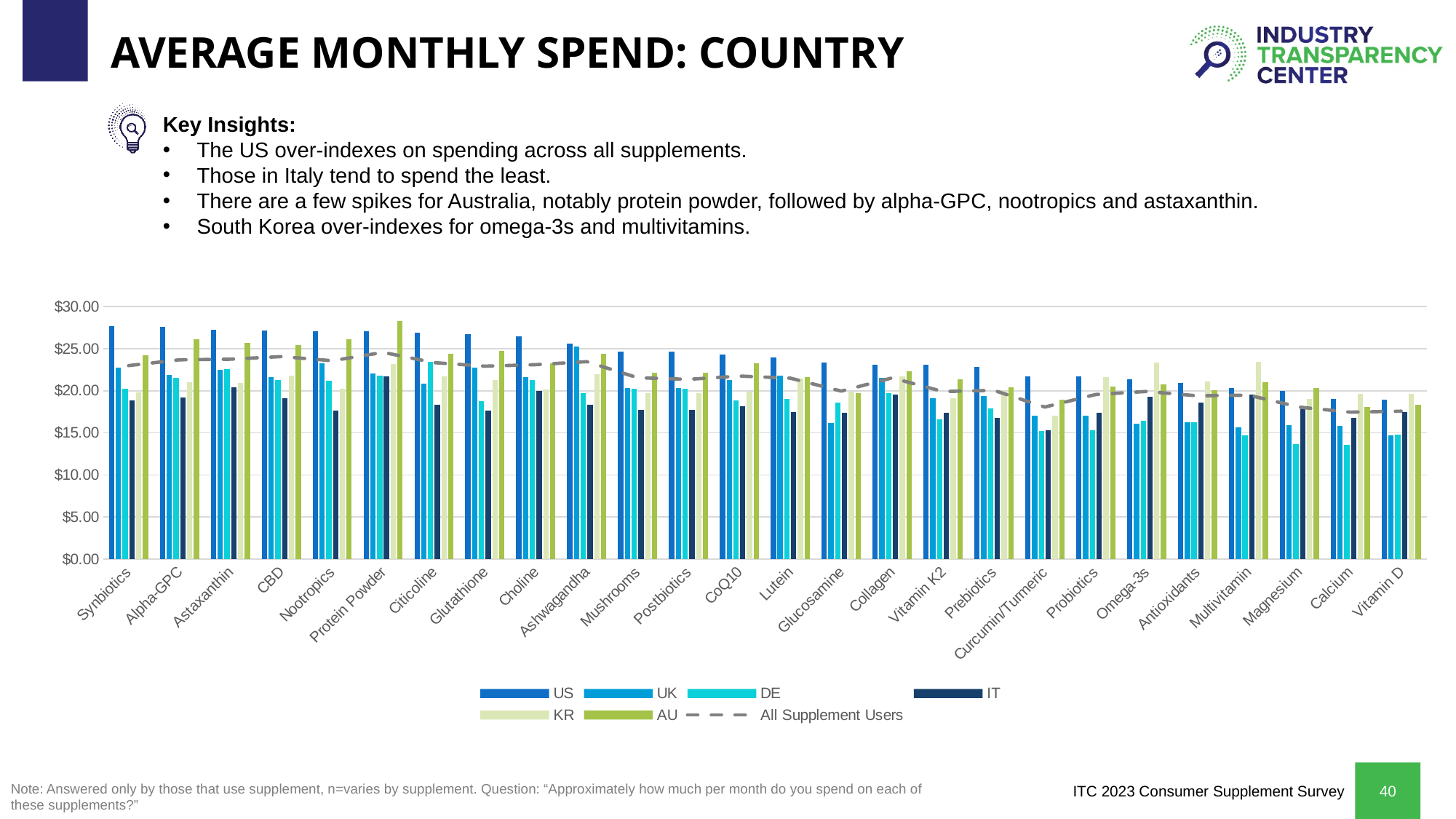
Is the value for UK for Glucosamine greater or less than $20.00? less How many supplement categories are shown along the x axis? 26 Is the value for US for Synbiotics greater or less than $25.00? greater Do the US values generally rise or fall moving from left to right across the supplement categories? fall What is the title of the chart? AVERAGE MONTHLY SPEND: COUNTRY For Synbiotics, which is larger: the US value or the IT value? US How many series does the legend list? 7 What does the dashed grey line in the chart represent? All Supplement Users Which country has the highest bar for Protein Powder? AU What kind of chart is shown on the slide? Bar chart (with a dashed line series) Is the value for AU for Protein Powder greater or less than $25.00? greater